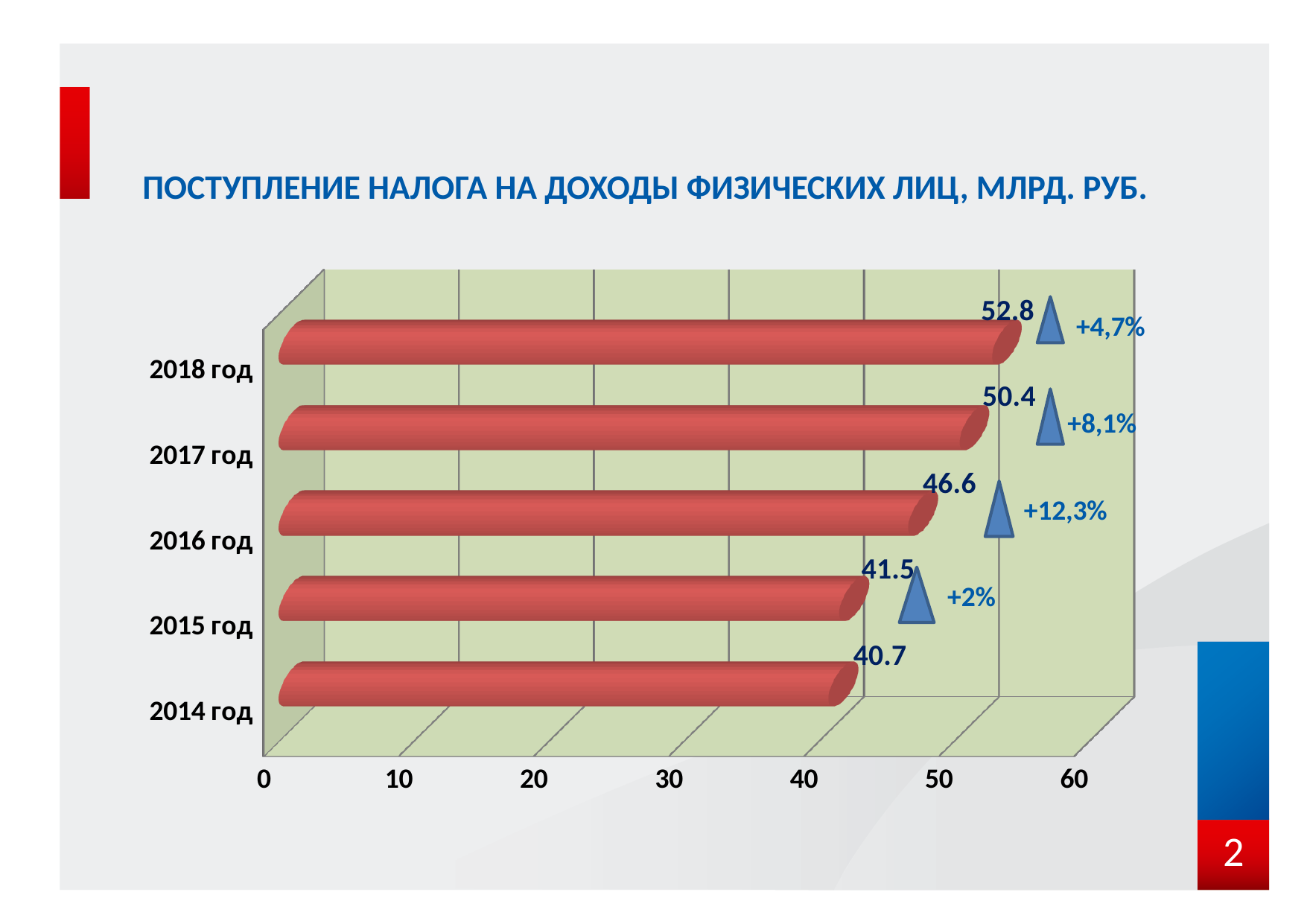
What percentage growth is shown next to the bar for 2016 год? +12,3% Which is larger, the value for 2017 год or the value for 2015 год? 2017 год Which year has the lowest value? 2014 год What is the value for 2014 год? 40.7 What is the difference between the values for 2016 год and 2014 год? 5.9 Which year has the highest value? 2018 год What is the difference between the values for 2018 год and 2017 год? 2.4 What kind of chart is shown on the slide? bar chart Do the values rise or fall from 2014 год to 2018 год? rise How many years are shown in the chart? 5 What is the value for 2016 год? 46.6 What is the value for 2018 год? 52.8